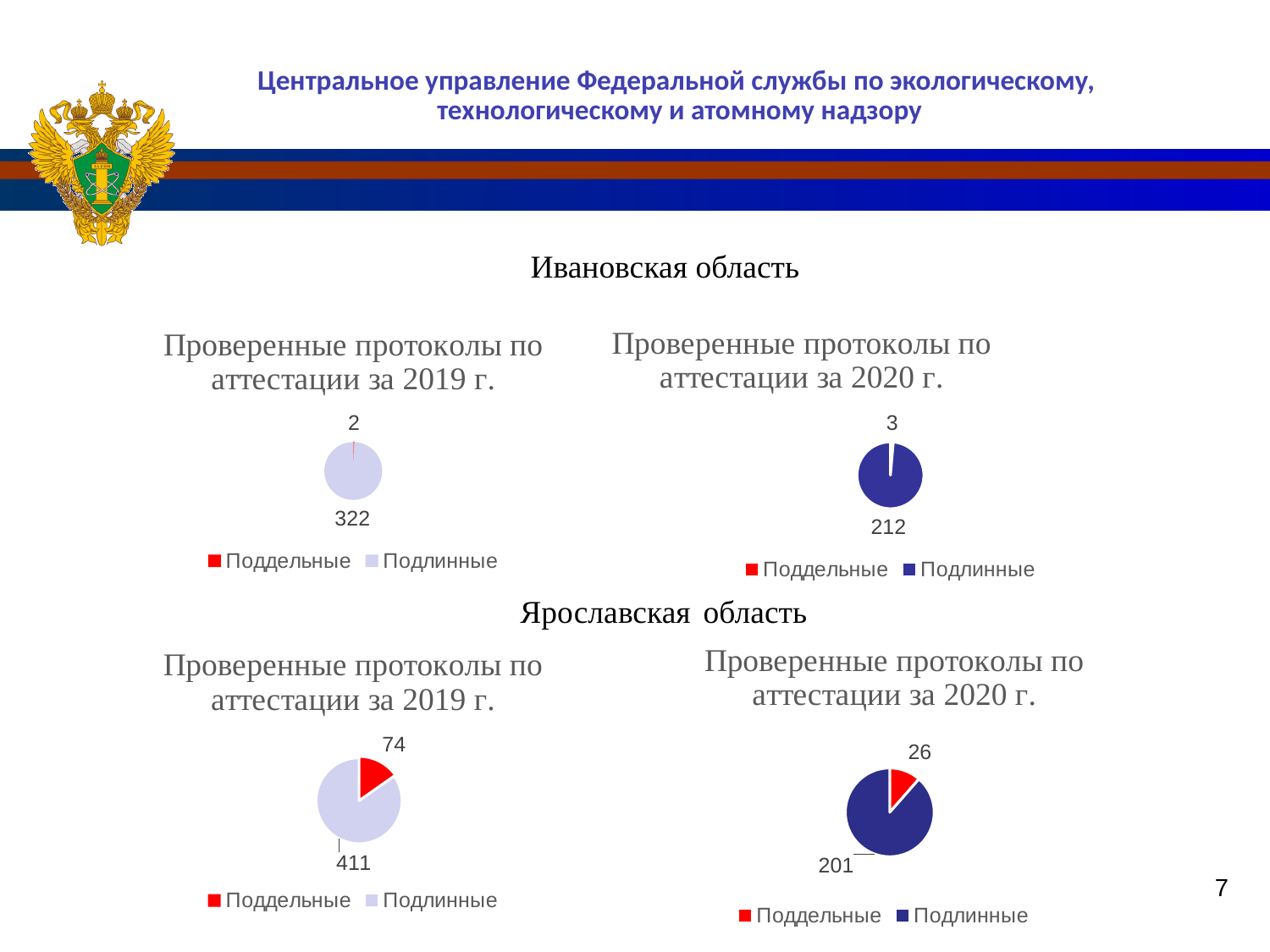
How many entries does the legend of the Ярославская область 2020 chart (bottom right) list? 2 In the Ивановская область chart for 2019 (top left), what is the value for Подлинные? 322 In the Ярославская область chart for 2020 (bottom right), what is the value for Подлинные? 201 In the Ярославская область chart for 2019 (bottom left), which category is the smallest? Поддельные Is the Поддельные value larger in the Ярославская область 2019 chart or the Ярославская область 2020 chart? 2019 In the Ярославская область chart for 2020 (bottom right), which category is the largest? Подлинные In the Ивановская область chart for 2019 (top left), what is the value for Поддельные? 2 In the Ивановская область chart for 2020 (top right), what is the total of Поддельные and Подлинные? 215 In the Ярославская область chart for 2019 (bottom left), what is the difference between Подлинные and Поддельные? 337 In the Ивановская область chart for 2020 (top right), what is the value for Подлинные? 212 In the Ярославская область chart for 2019 (bottom left), what is the value for Поддельные? 74 What type of chart is used for the Ивановская область 2019 data (top left)? Pie chart